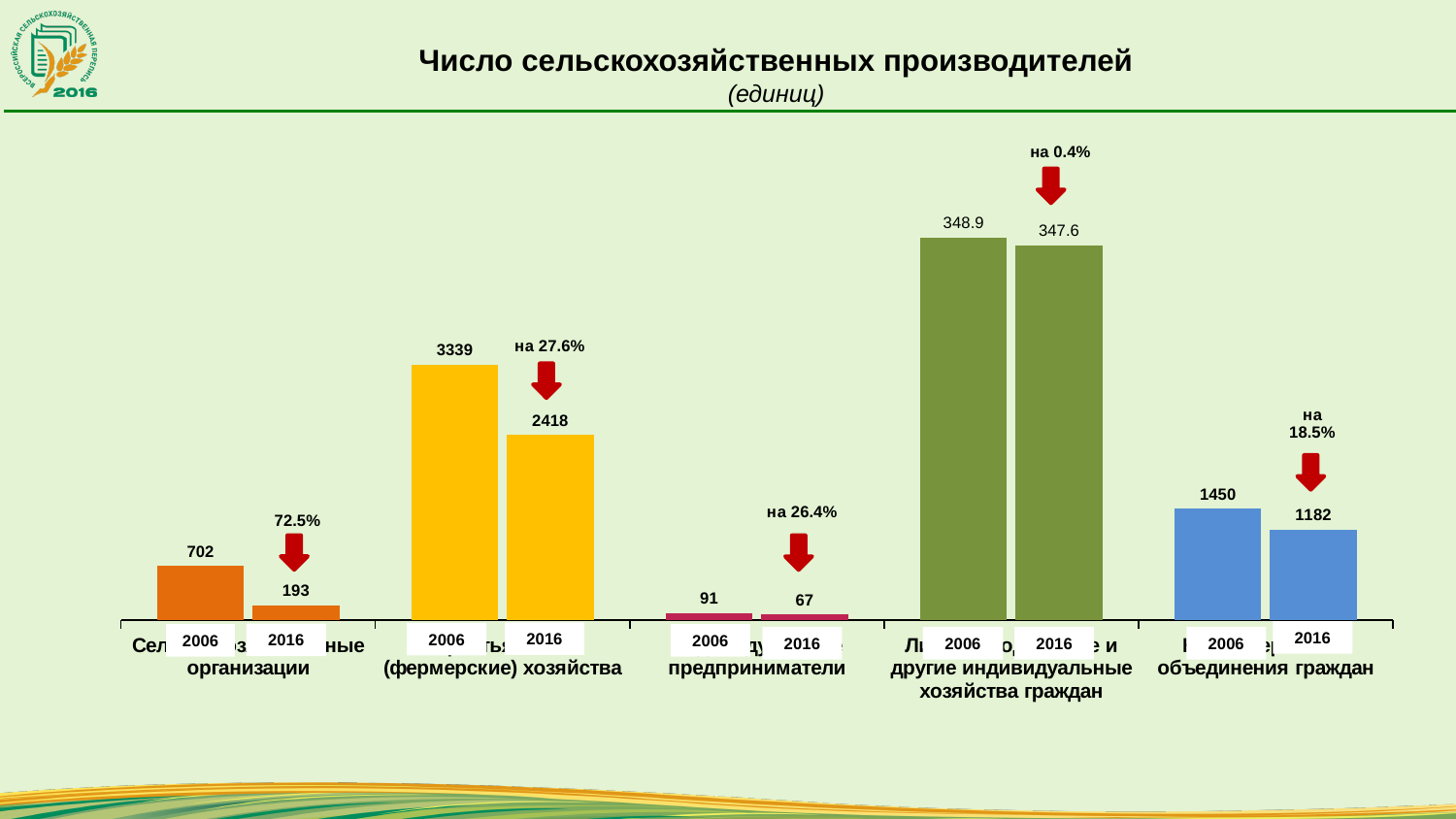
What is the difference between the 2006 and 2016 values for the category ending in "(фермерские) хозяйства"? 921 How many category groups are shown in the chart? 5 What is the difference between the 2006 and 2016 values for the category ending in "объединения граждан"? 268 What is the value for 2006 for the category ending in "(фермерские) хозяйства"? 3339 What kind of chart is shown on the slide? Bar chart What percentage decrease is shown above the bars for the category ending in "(фермерские) хозяйства"? на 27.6% What is the value for 2016 for the category ending in "предприниматели"? 67 What is the value for 2006 for the category ending in "организации"? 702 What is the value for 2016 for the category ending in "объединения граждан"? 1182 For the category ending in "другие индивидуальные хозяйства граждан", which year has the larger value, 2006 or 2016? 2006 What is the value for 2016 for the category ending in "другие индивидуальные хозяйства граждан"? 347.6 What is the difference between the 2006 and 2016 values for the category ending in "организации"? 509